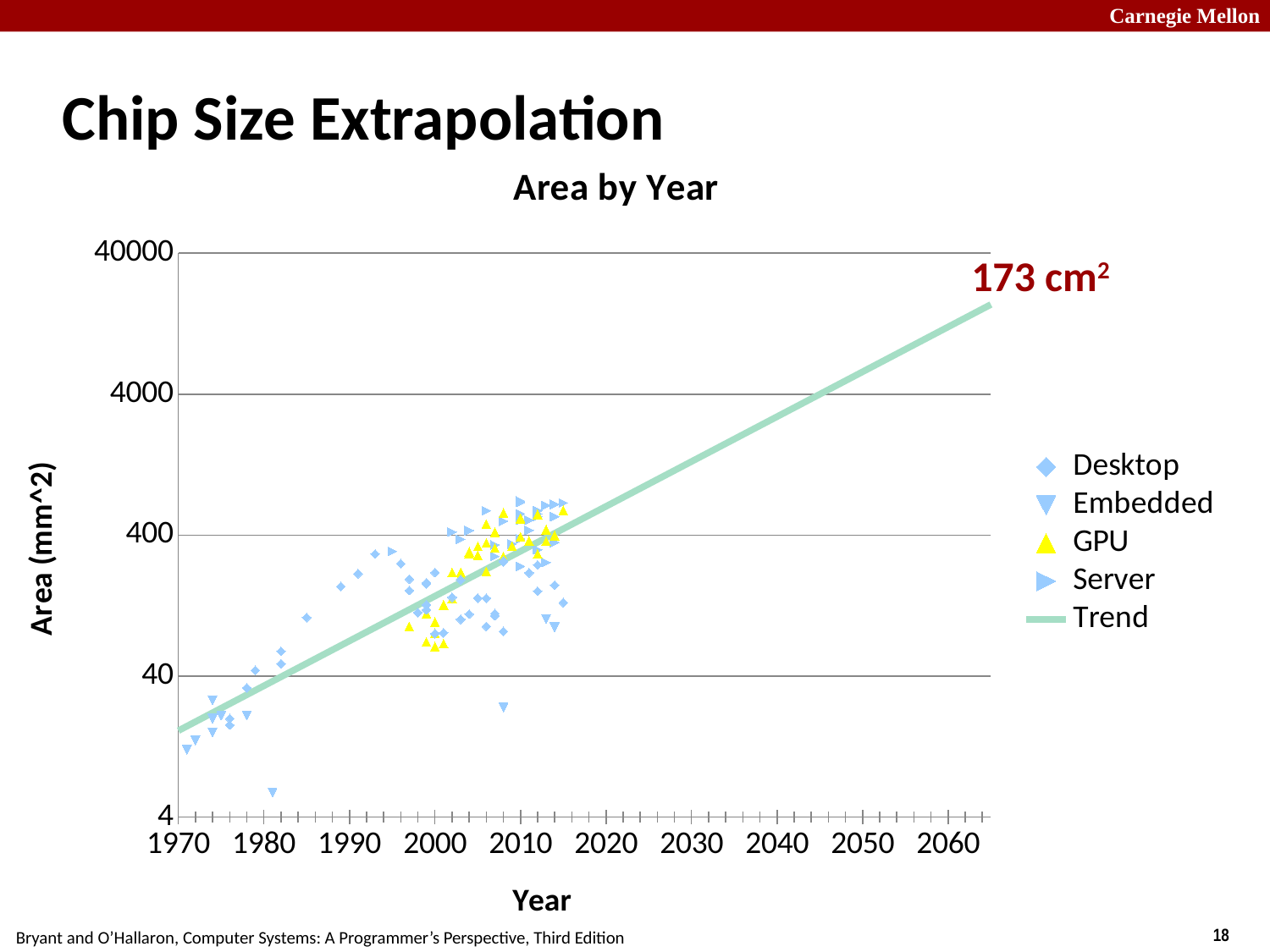
Does the Trend line rise or fall as the year increases? rises What is the label of the y axis? Area (mm^2) What value is annotated at the upper end of the Trend line? 173 cm² How many year labels are shown on the x axis? 10 Is the Embedded point near 1981 greater or less than 40? less Are the GPU points near 2000 greater or less than 400? less What is the title of the chart? Area by Year Is the value of the Trend line at 2060 greater or less than 4000? greater What kind of chart is shown on the slide? scatter chart How many series does the legend list? 5 Which series is plotted with yellow triangles? GPU